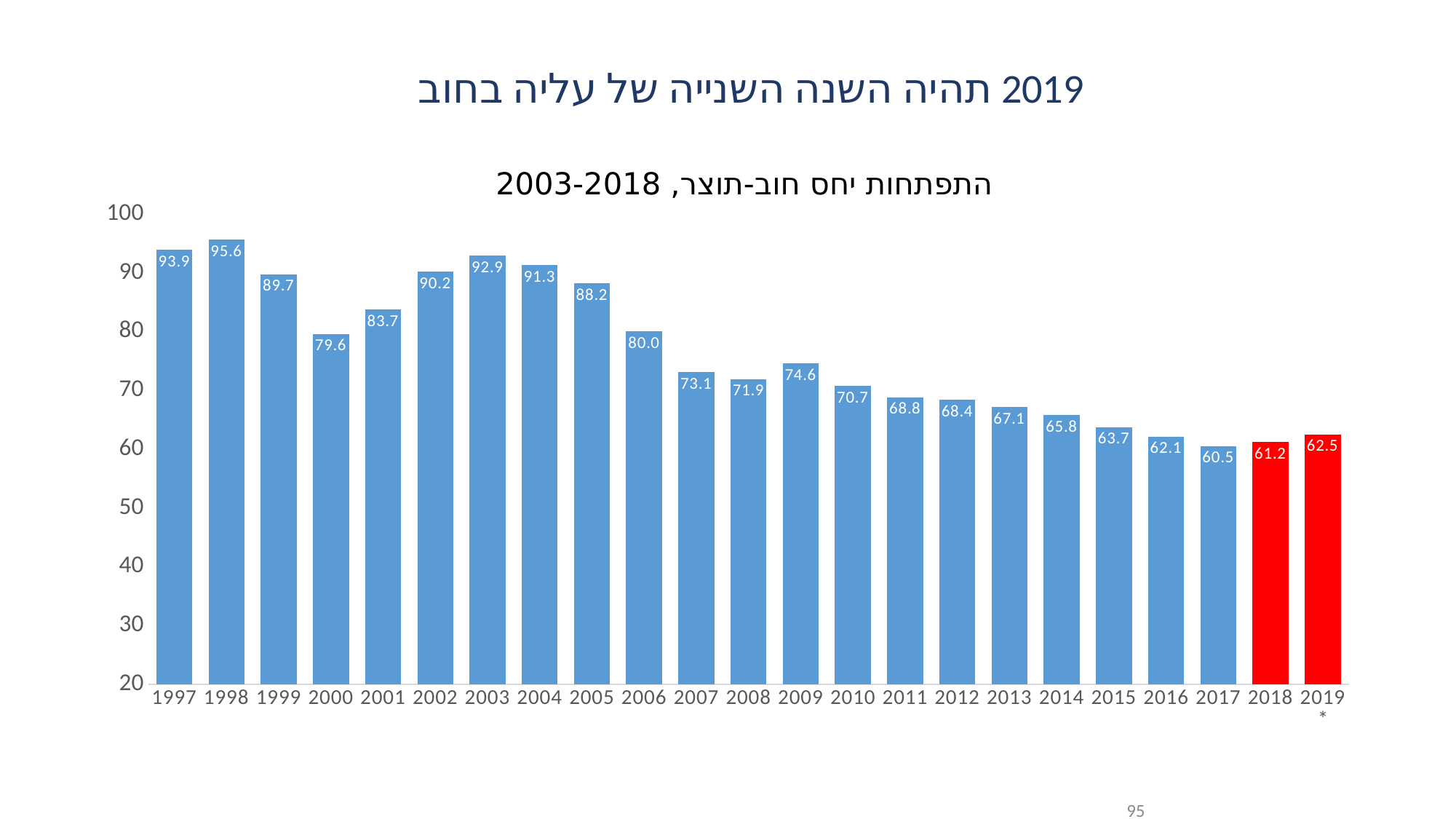
Which bars are coloured red rather than blue? 2018 and 2019* What is the value for 2019*? 62.5 Which year has the lowest value? 2017 How many years are shown on the x axis? 23 What kind of chart is this? bar chart What is the difference between the values for 1997 and 2019*? 31.4 Is the value for 2006 greater or less than 70? greater Which is larger, the value for 2009 or the value for 2010? 2009 Which year has the highest value? 1998 What is the value for 2000? 79.6 What is the value for 2008? 71.9 What is the difference between the values for 2018 and 2017? 0.7